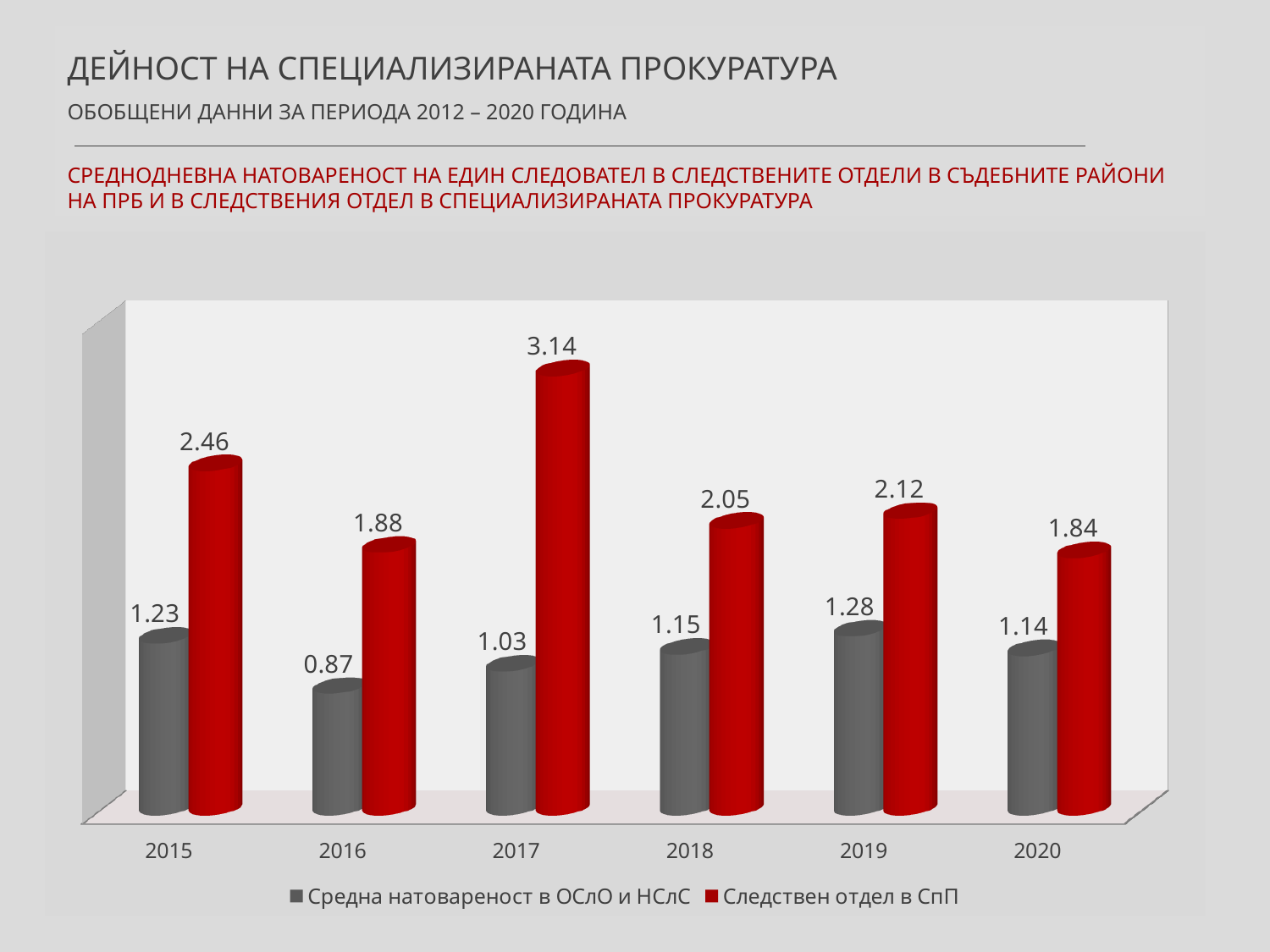
What is the difference between the "Следствен отдел в СпП" values for 2015 and 2016? 0.58 In which year is the value for "Средна натовареност в ОСлО и НСлС" lowest? 2016 How many years are shown on the x axis? 6 Which is larger in 2019: "Средна натовареност в ОСлО и НСлС" or "Следствен отдел в СпП"? Следствен отдел в СпП How many series does the legend list? 2 What kind of chart is shown on the slide? Bar chart In which year is the value for "Средна натовареност в ОСлО и НСлС" highest? 2019 What is the value for "Следствен отдел в СпП" in 2017? 3.14 What is the value for "Следствен отдел в СпП" in 2020? 1.84 What is the difference between the two series in 2017? 2.11 In which year is the value for "Следствен отдел в СпП" highest? 2017 What is the value for "Средна натовареност в ОСлО и НСлС" in 2016? 0.87